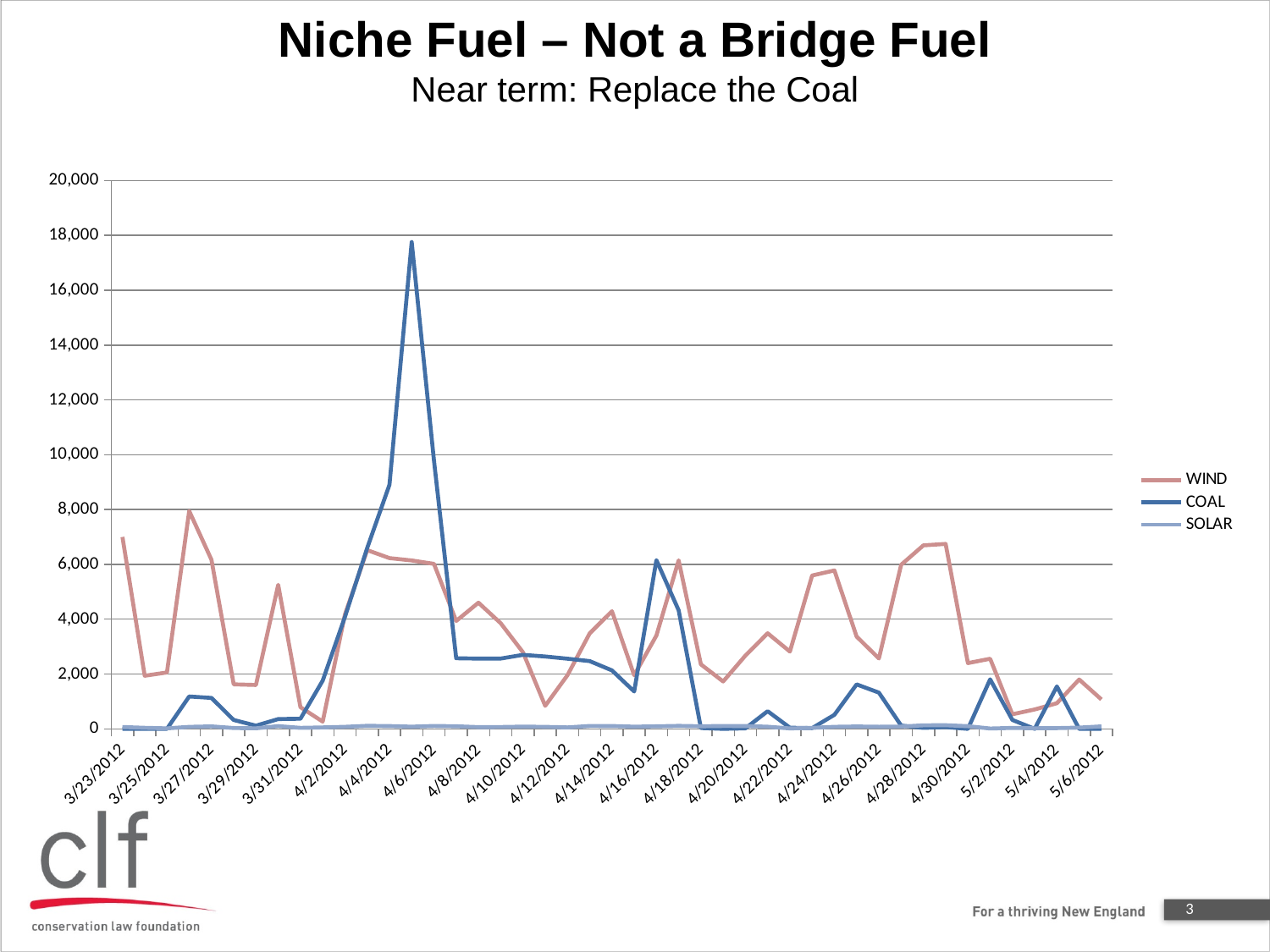
What is the highest value shown on the vertical axis? 20,000 How many series does the chart's legend list? 3 Does the COAL series rise or fall between 4/2/2012 and its peak just after 4/4/2012? rise What kind of chart is shown on the slide? line chart Which series reaches the highest value anywhere on the chart? COAL At the COAL peak between 4/4/2012 and 4/6/2012, which series is larger, COAL or WIND? COAL Is the peak value of the COAL series greater or less than 16,000? greater Is the value for SOLAR on 4/6/2012 greater or less than 2,000? less Is the value for WIND on 3/23/2012 greater or less than 6,000? greater On 3/23/2012, which series has the larger value, WIND or COAL? WIND What are the three series named in the legend? WIND, COAL, SOLAR Which series stays lowest across the whole chart? SOLAR